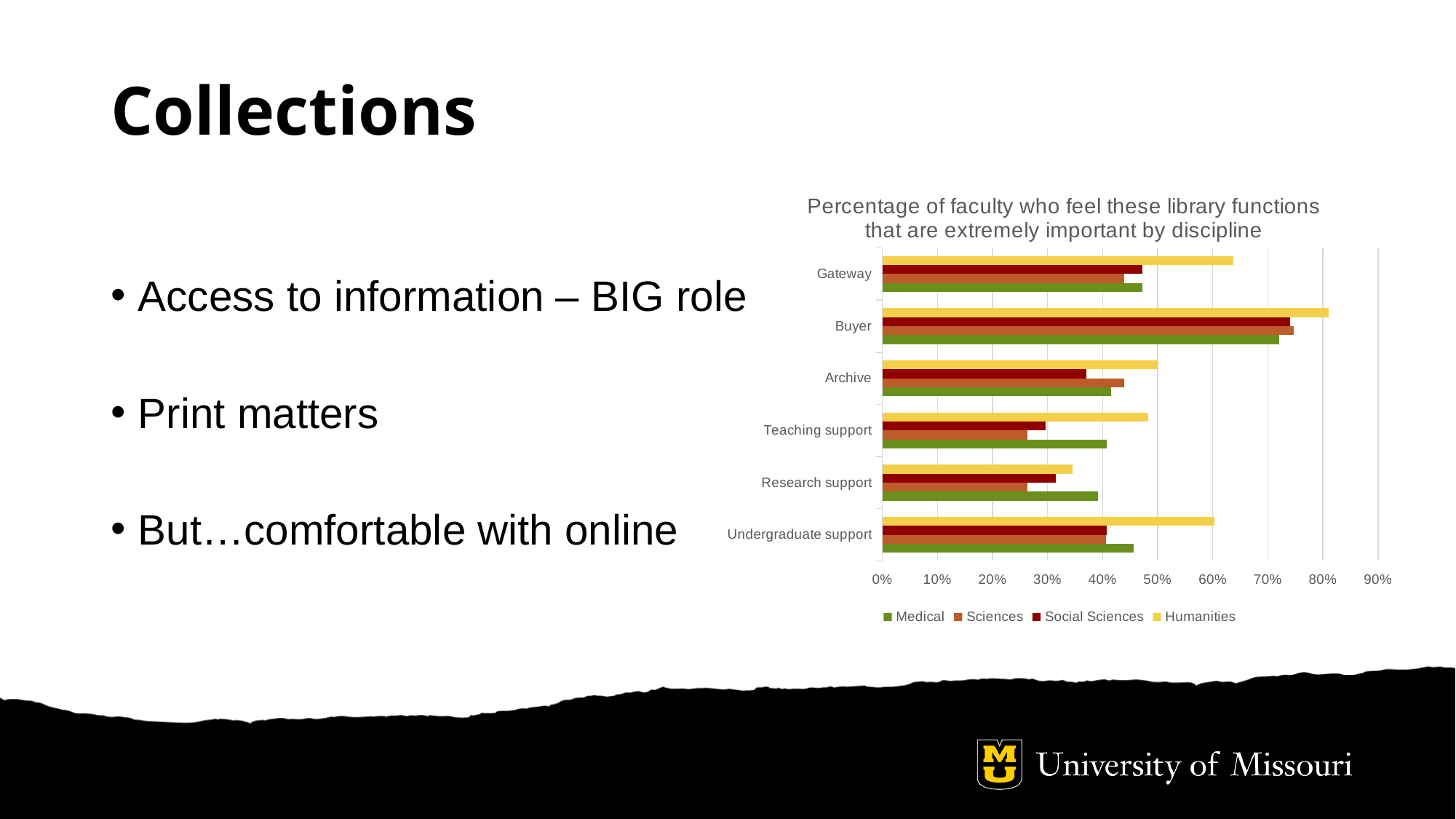
How many series does the chart's legend list? 4 Which library function has the highest value for Humanities? Buyer What kind of chart is shown on the slide? bar chart Is the Sciences value for Research support greater or less than 30%? less Which library function has the lowest value for Humanities? Research support Is the Humanities value for Buyer greater or less than 70%? greater What is the title of the chart? Percentage of faculty who feel these library functions that are extremely important by discipline For Gateway, which is larger: the Humanities value or the Medical value? Humanities Is the Medical value for Buyer greater or less than 60%? greater How many library functions (categories) are listed on the chart? 6